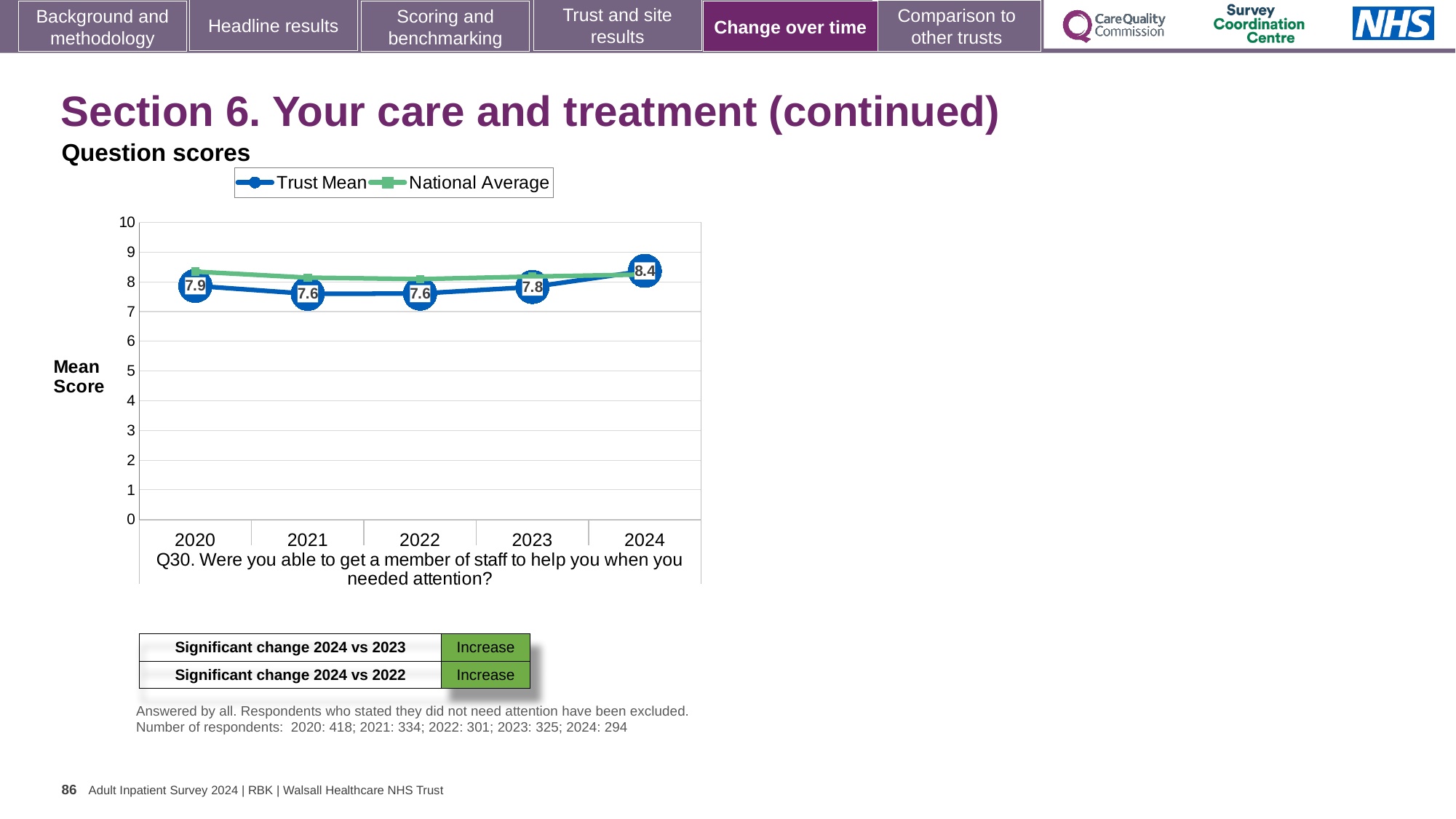
What is the lowest Trust Mean score shown on the chart? 7.6 How many years are shown on the x axis of the chart? 5 Is the National Average value for 2020 greater or less than 8? greater Which year has the larger Trust Mean score, 2020 or 2021? 2020 In 2021, which series has the higher value, Trust Mean or National Average? National Average What is the difference between the Trust Mean scores for 2024 and 2023? 0.6 What is the Trust Mean score for 2020? 7.9 What kind of chart is shown on the slide? line chart How many series does the legend list? 2 What is the Trust Mean score for 2024? 8.4 What is the Trust Mean score for 2023? 7.8 In which year is the Trust Mean score highest? 2024